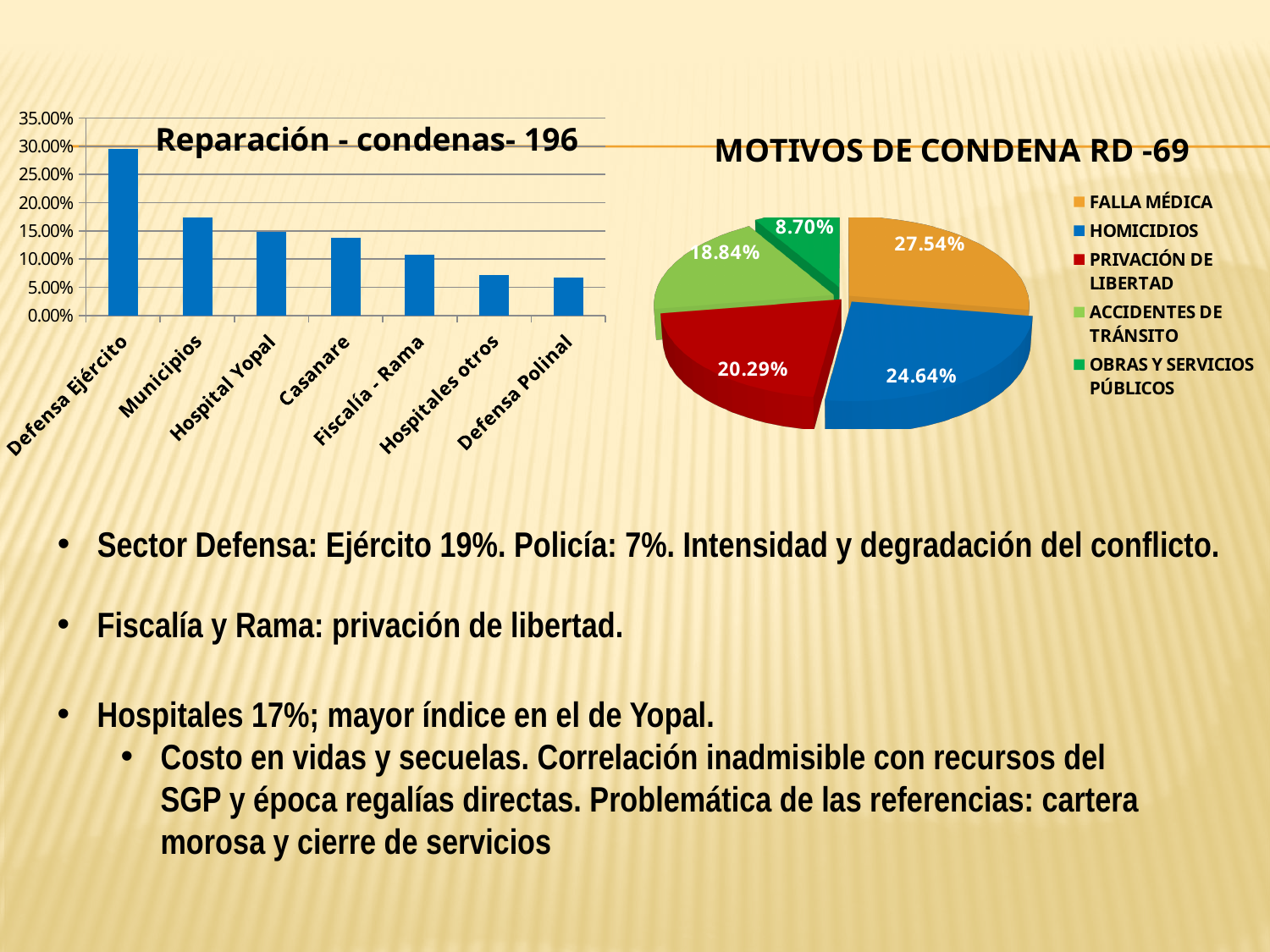
In the 'MOTIVOS DE CONDENA RD -69' pie chart, what percentage is shown for FALLA MÉDICA? 27.54% In the 'MOTIVOS DE CONDENA RD -69' pie chart, what is the difference in percentage points between PRIVACIÓN DE LIBERTAD and ACCIDENTES DE TRÁNSITO? 1.45 In the 'MOTIVOS DE CONDENA RD -69' pie chart, which is larger: HOMICIDIOS or PRIVACIÓN DE LIBERTAD? HOMICIDIOS How many categories does the legend of the 'MOTIVOS DE CONDENA RD -69' pie chart list? 5 In the 'Reparación - condenas- 196' bar chart, is the value for Municipios greater or less than 15.00%? greater In the 'MOTIVOS DE CONDENA RD -69' pie chart, which category has the smallest share? OBRAS Y SERVICIOS PÚBLICOS In the 'MOTIVOS DE CONDENA RD -69' pie chart, what percentage is shown for HOMICIDIOS? 24.64% In the 'MOTIVOS DE CONDENA RD -69' pie chart, which category has the largest share? FALLA MÉDICA How many categories are shown in the 'Reparación - condenas- 196' bar chart? 7 What type of chart is 'Reparación - condenas- 196'? Bar chart In the 'MOTIVOS DE CONDENA RD -69' pie chart, what percentage is shown for OBRAS Y SERVICIOS PÚBLICOS? 8.70% In the 'Reparación - condenas- 196' bar chart, which category has the highest value? Defensa Ejército